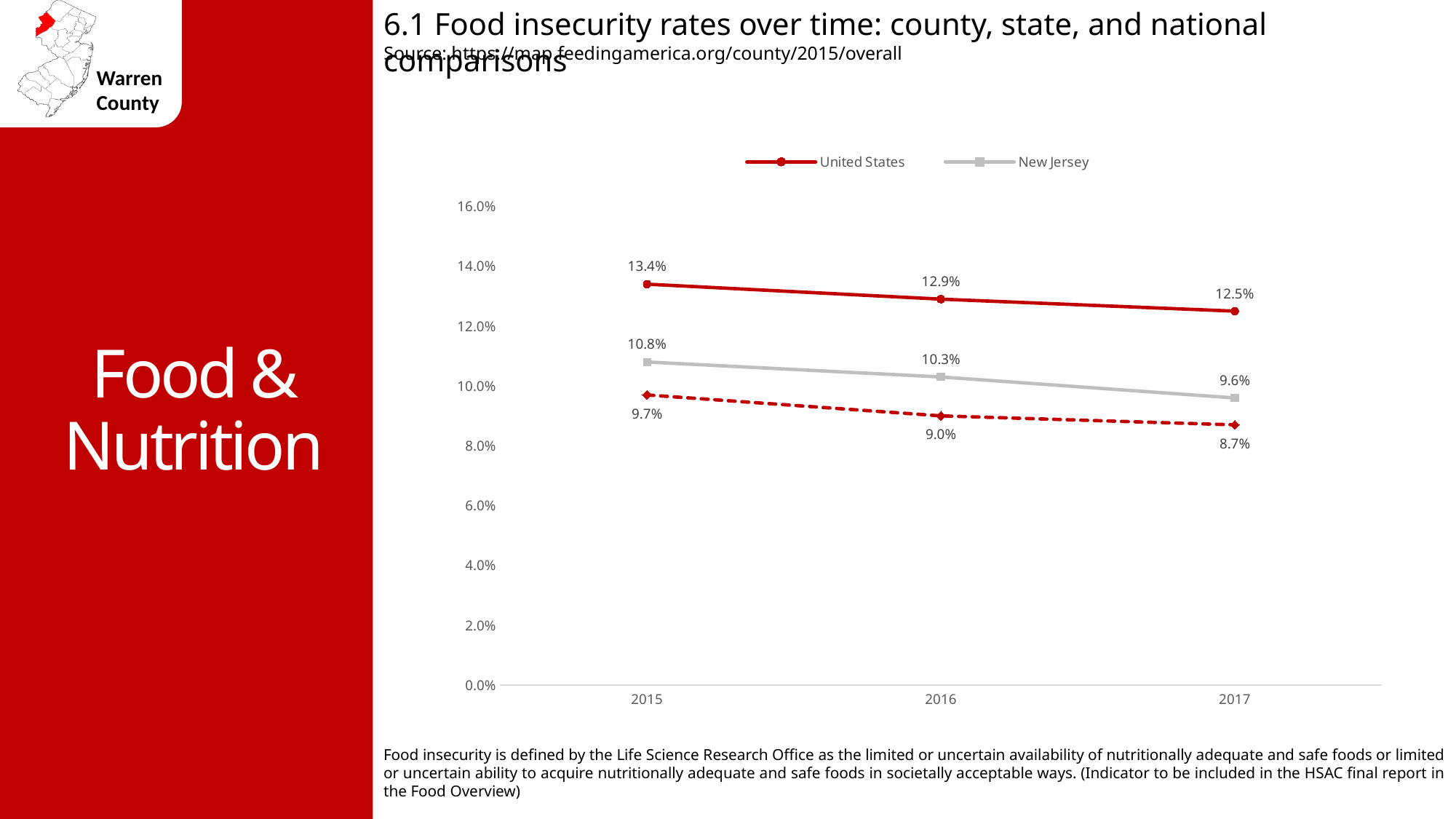
What kind of chart is shown on the slide? Line chart By how many percentage points did the United States rate fall from 2015 to 2017? 0.9 percentage points In which year was the New Jersey rate highest? 2015 In 2015, which had the higher food insecurity rate, the United States or New Jersey? United States What was the food insecurity rate for New Jersey in 2017? 9.6% What was the food insecurity rate for the United States in 2017? 12.5% What was the food insecurity rate for New Jersey in 2016? 10.3% How many series does the legend list? 2 What was the food insecurity rate for the United States in 2015? 13.4% How many years are shown on the x axis? 3 In 2016, how much higher was the United States rate than the New Jersey rate? 2.6 percentage points Does the United States line rise or fall from 2015 to 2017? Falls